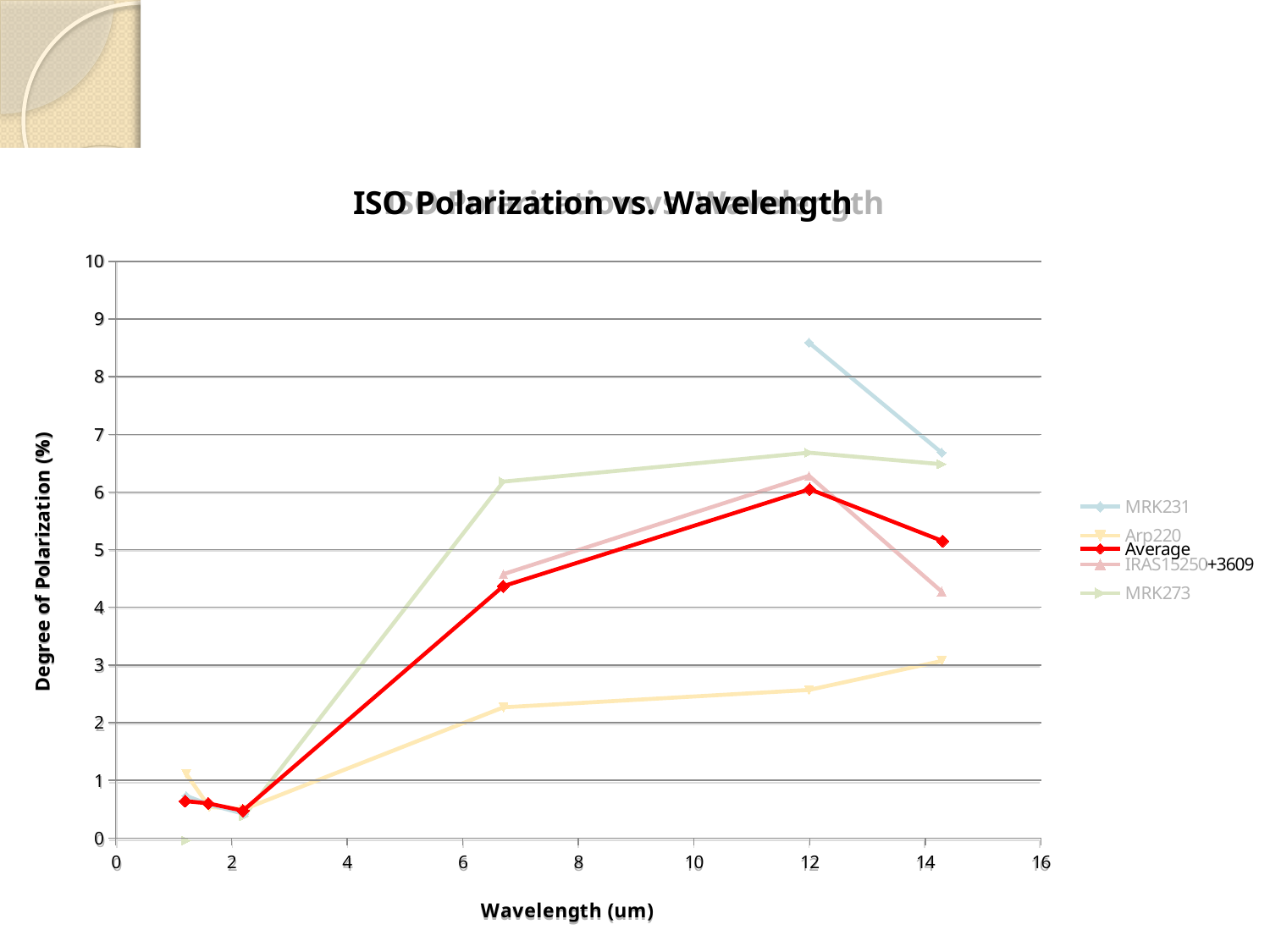
What is the title of the chart? ISO Polarization vs. Wavelength How many series does the legend list? 5 Is the value for MRK231 at a wavelength of about 12 um greater or less than 8? greater Does the Average series rise or fall between wavelengths of about 12 um and 14 um? fall Is the value for MRK273 at a wavelength of about 7 um greater or less than 5? greater What is the label of the vertical axis? Degree of Polarization (%) Is the value for Arp220 at a wavelength of about 14 um greater or less than 4? less At a wavelength of about 12 um, which is larger: MRK231 or Average? MRK231 What kind of chart is shown on the slide? line chart Which series reaches the highest degree of polarization on the chart? MRK231 At a wavelength of about 14 um, which is larger: MRK273 or IRAS15250+3609? MRK273